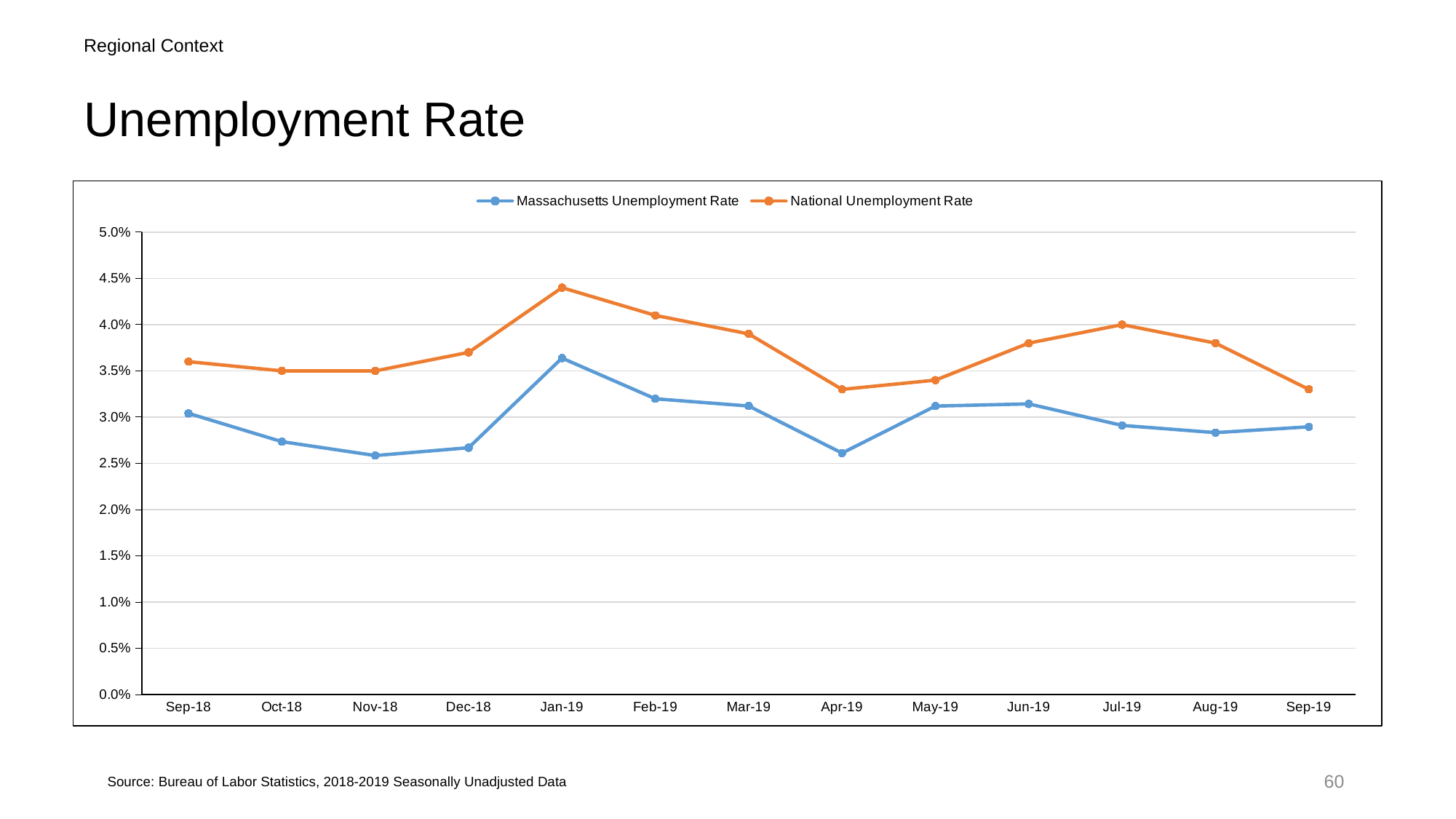
Does the National Unemployment Rate rise or fall from Jan-19 to Apr-19? fall What kind of chart is shown on the slide? line chart In which month is the National Unemployment Rate highest? Jan-19 In which month is the Massachusetts Unemployment Rate highest? Jan-19 Which colour is used for the Massachusetts Unemployment Rate line? blue How many months are plotted along the x axis? 13 Is the Massachusetts Unemployment Rate in Jan-19 greater or less than 3.5%? greater Is the Massachusetts Unemployment Rate in Nov-18 greater or less than 3.0%? less What is the National Unemployment Rate in Jul-19? 4.0% How many series does the legend list? 2 Which is larger in Jan-19, the Massachusetts Unemployment Rate or the National Unemployment Rate? National Unemployment Rate Is the National Unemployment Rate in Apr-19 greater or less than 3.5%? less